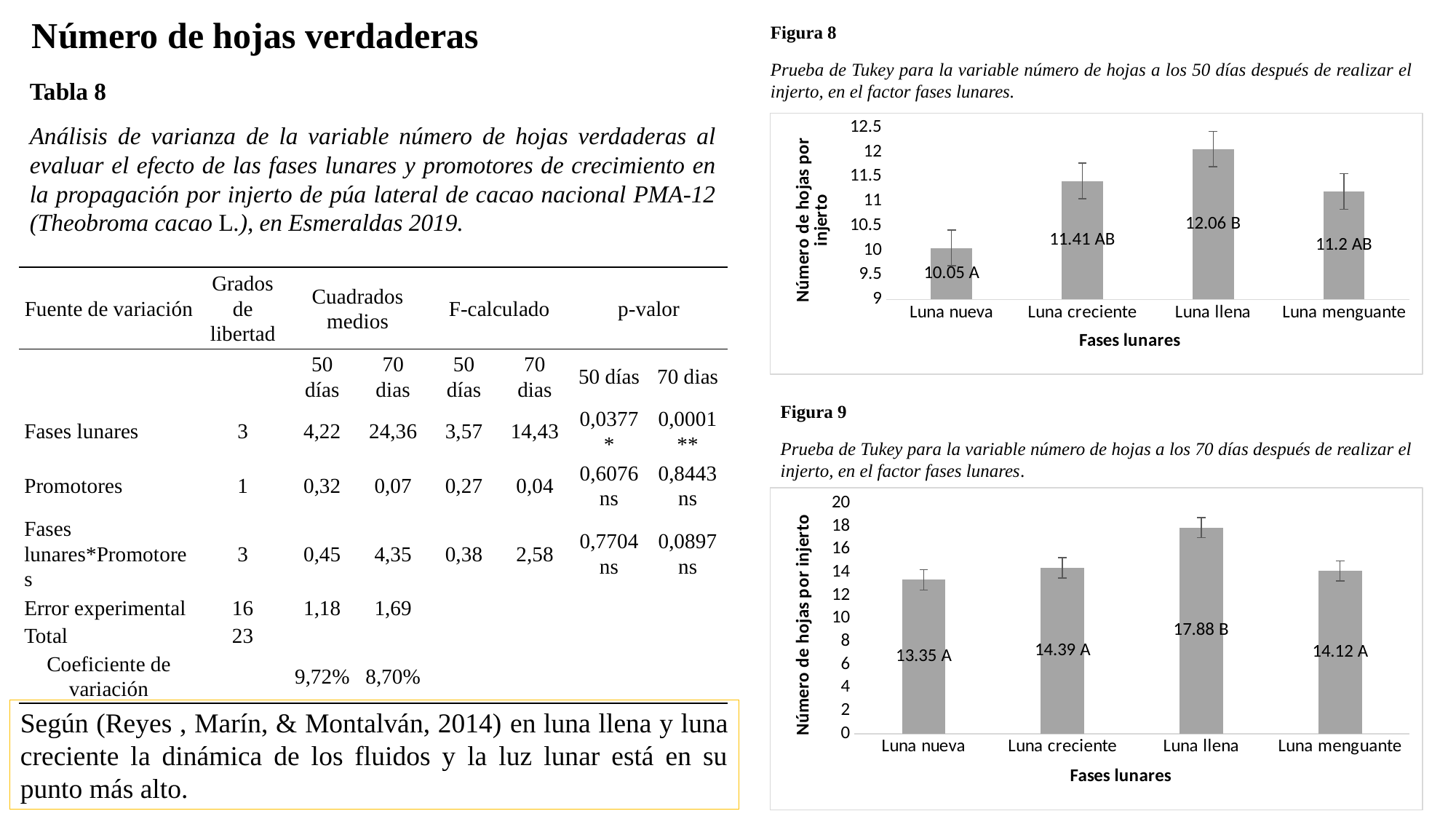
In Figura 9 (70 días), which lunar phase has the lowest value? Luna nueva In Figura 8 (50 días), which lunar phase has the highest number of leaves per graft? Luna llena In Figura 8 (50 días), how many lunar phases are plotted? 4 In Figura 9 (70 días), what is the value for Luna llena? 17.88 What type of chart is Figura 8? Bar chart In Figura 9 (70 días), what is the value for Luna menguante? 14.12 What is the x-axis title of Figura 9? Fases lunares In Figura 9 (70 días), what is the difference between the values for Luna llena and Luna nueva? 4.53 In Figura 9 (70 días), is the value for Luna creciente greater or less than 12? greater In Figura 8 (50 días), what is the value for Luna nueva? 10.05 In Figura 8 (50 días), what is the difference between the values for Luna llena and Luna nueva? 2.01 In Figura 8 (50 días), which lunar phase has the lowest number of leaves per graft? Luna nueva